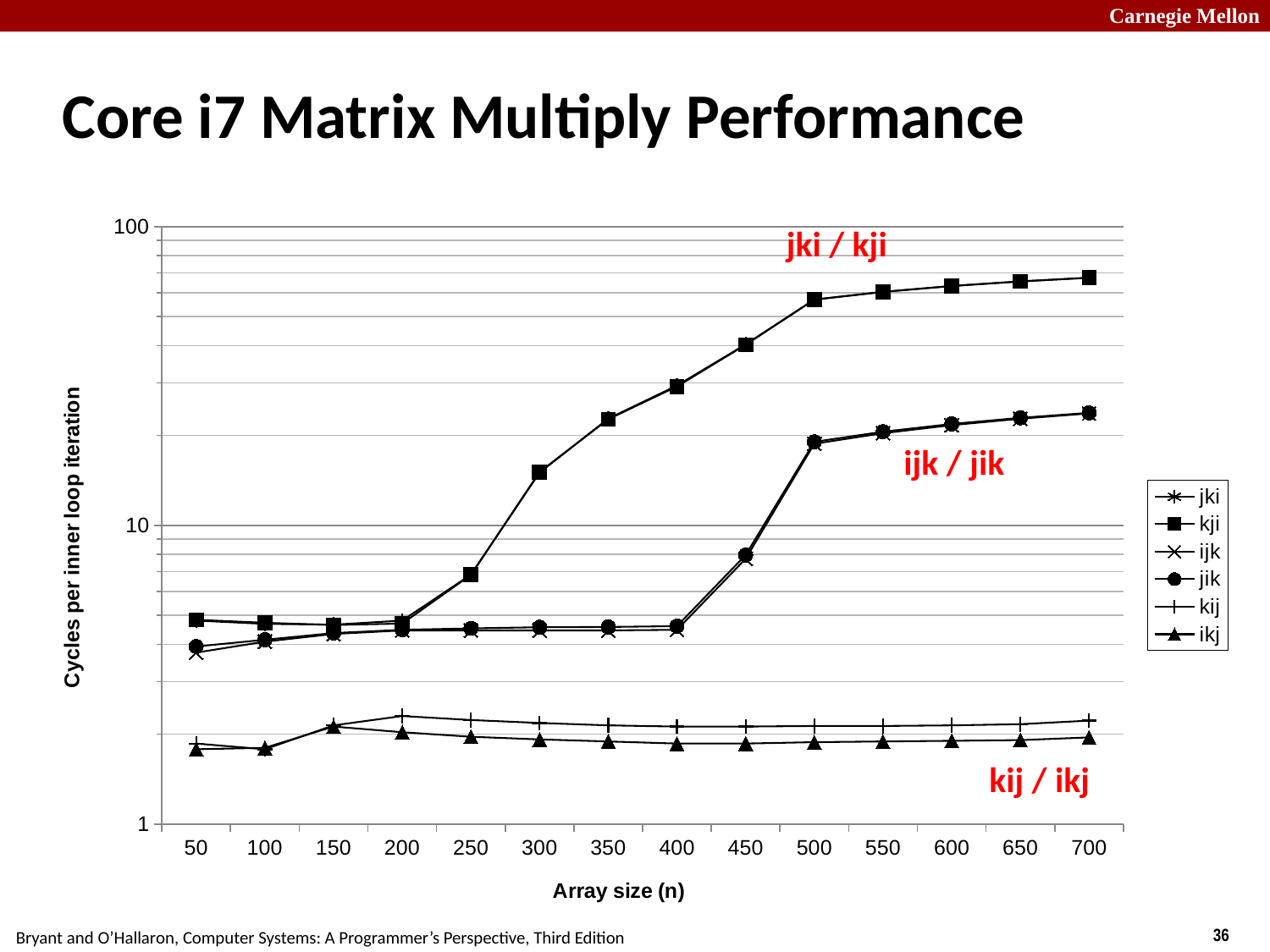
Is the value for jik at array size 400 greater or less than 10? less Which pair of series, as labelled in red on the chart, has the lowest cycles per inner loop iteration? kij / ikj How many series does the legend list? 6 What kind of chart is shown on the slide? line chart Which pair of series, as labelled in red on the chart, has the highest cycles per inner loop iteration at large array sizes? jki / kji Is the value for kij at array size 700 greater or less than 10? less How many array sizes are plotted along the x axis? 14 Does the value for kji rise or fall as the array size increases from 200 to 500? rise What is the label of the y axis? Cycles per inner loop iteration At array size 700, which is larger: the value for kji or the value for jik? kji Is the value for kji at array size 500 greater or less than 10? greater